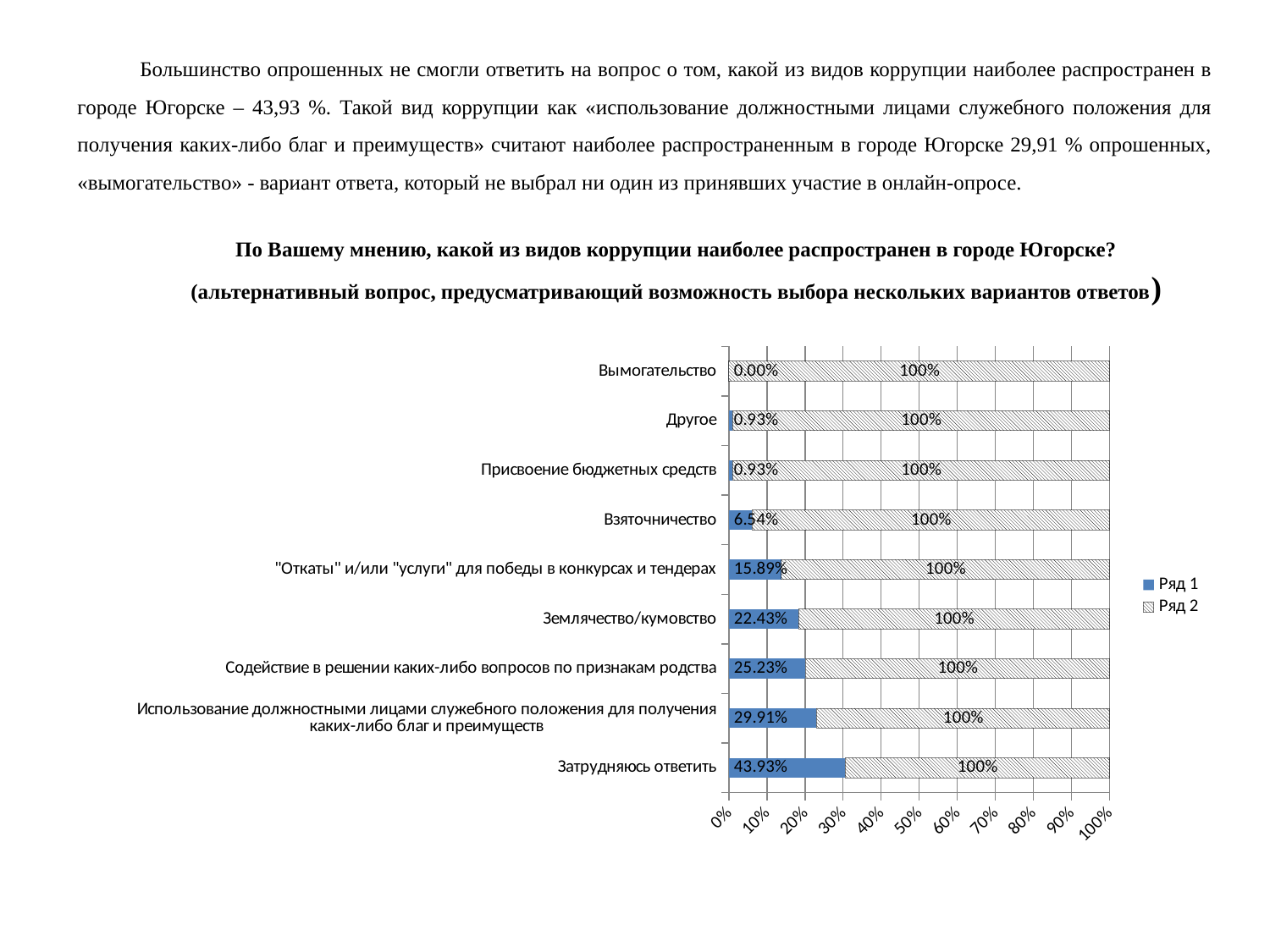
Which has a larger Ряд 1 value: "Содействие в решении каких-либо вопросов по признакам родства" or "Откаты" и/или "услуги" для победы в конкурсах и тендерах? Содействие в решении каких-либо вопросов по признакам родства What is the difference between the Ряд 1 values for "Затрудняюсь ответить" and "Использование должностными лицами служебного положения для получения каких-либо благ и преимуществ"? 14.02% How many series does the legend list? 2 What is the Ряд 1 value for "Вымогательство"? 0.00% What is the Ряд 1 value for "Взяточничество"? 6.54% What is the Ряд 1 value for "Затрудняюсь ответить"? 43.93% What is the Ряд 1 value for "Землячество/кумовство"? 22.43% What type of chart is shown on the slide? bar chart Which category has the lowest Ряд 1 value? Вымогательство What is the Ряд 2 value shown for each category? 100% Which category has the highest Ряд 1 value? Затрудняюсь ответить How many categories are shown on the chart? 9